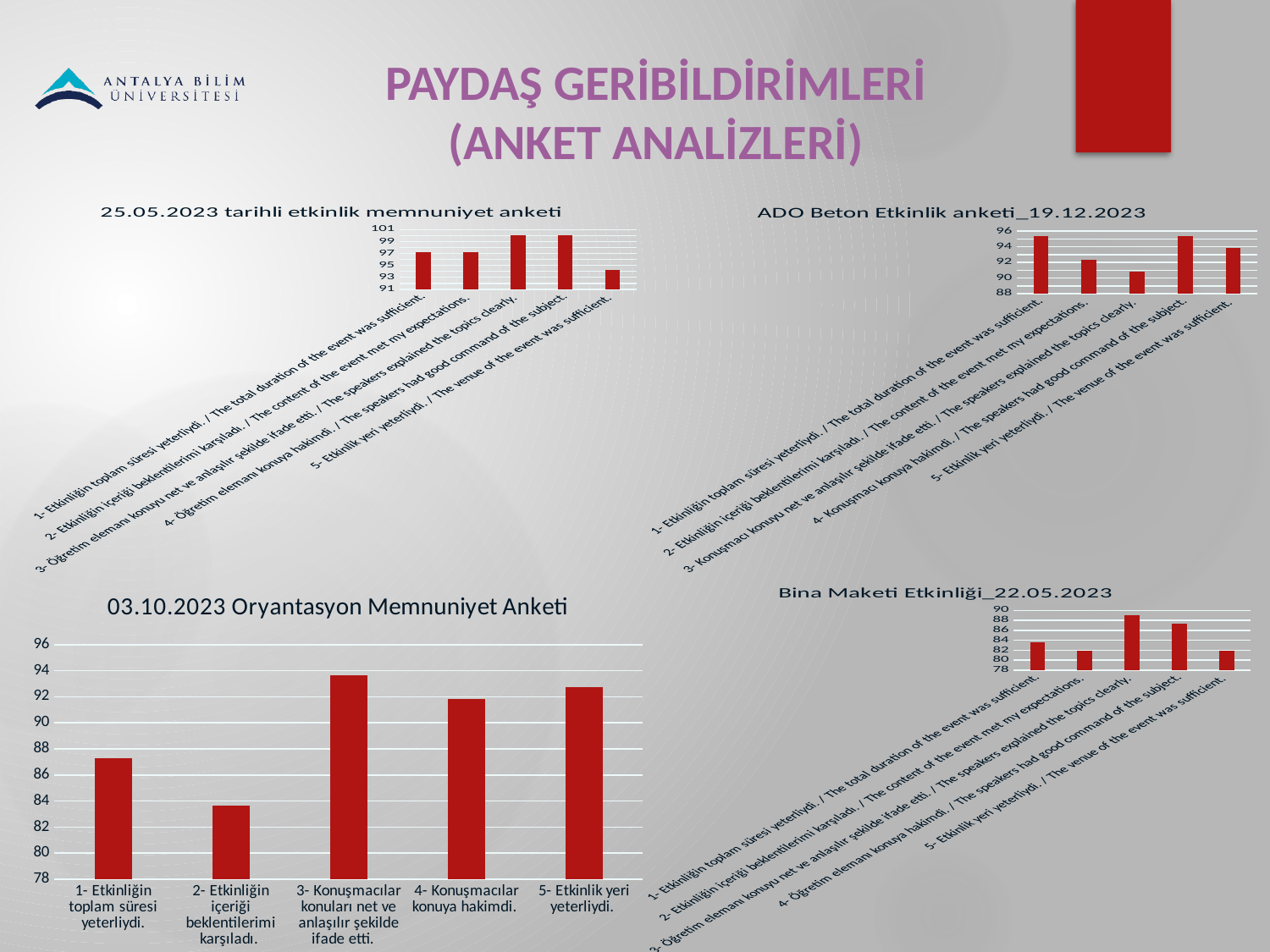
In the '03.10.2023 Oryantasyon Memnuniyet Anketi' chart, which category has the highest value? 3- Konuşmacılar konuları net ve anlaşılır şekilde ifade etti. In the '25.05.2023 tarihli etkinlik memnuniyet anketi' chart, which category has the lowest value? 5- Etkinlik yeri yeterliydi. / The venue of the event was sufficient. In the '03.10.2023 Oryantasyon Memnuniyet Anketi' chart, which category has the lowest value? 2- Etkinliğin içeriği beklentilerimi karşıladı. How many charts are shown on the slide? 4 In the '03.10.2023 Oryantasyon Memnuniyet Anketi' chart, is the value for '2- Etkinliğin içeriği beklentilerimi karşıladı.' greater or less than 86? less In the 'ADO Beton Etkinlik anketi_19.12.2023' chart, which category has the lowest value? 3- Konuşmacı konuyu net ve anlaşılır şekilde ifade etti. / The speakers explained the topics clearly. In the 'Bina Maketi Etkinliği_22.05.2023' chart, which category has the highest value? 3- Öğretim elemanı konuyu net ve anlaşılır şekilde ifade etti. / The speakers explained the topics clearly. In the '03.10.2023 Oryantasyon Memnuniyet Anketi' chart, which is larger: the value for '1- Etkinliğin toplam süresi yeterliydi.' or for '2- Etkinliğin içeriği beklentilerimi karşıladı.'? 1- Etkinliğin toplam süresi yeterliydi. What kind of chart is the '03.10.2023 Oryantasyon Memnuniyet Anketi' chart? bar chart In the '03.10.2023 Oryantasyon Memnuniyet Anketi' chart, is the value for '1- Etkinliğin toplam süresi yeterliydi.' greater or less than 86? greater How many categories are shown in the '03.10.2023 Oryantasyon Memnuniyet Anketi' chart? 5 In the 'Bina Maketi Etkinliği_22.05.2023' chart, is the value for '3- Öğretim elemanı konuyu net ve anlaşılır şekilde ifade etti.' greater or less than 88? greater